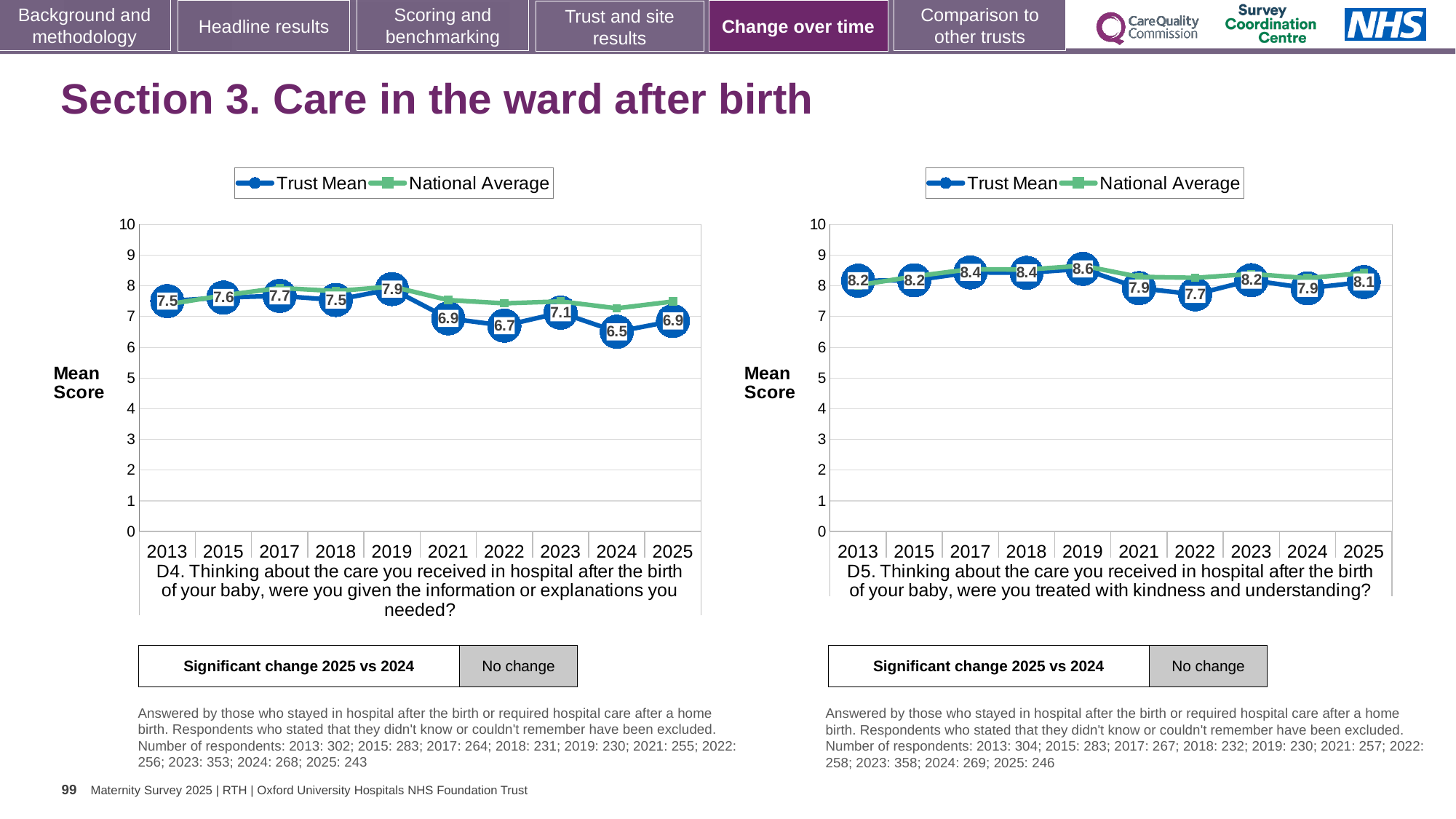
In the left chart (D4), is the National Average for 2025 greater or less than 7? greater In the right chart (D5), what is the Trust Mean score for 2019? 8.6 In the right chart (D5), is the Trust Mean score for 2025 higher or lower than for 2024? higher In the left chart (D4), what is the Trust Mean score for 2019? 7.9 In the left chart (D4), which year has the highest Trust Mean score? 2019 In the left chart (D4), what is the difference between the Trust Mean scores for 2019 and 2024? 1.4 In the right chart (D5), which year has the lowest Trust Mean score? 2022 How many years are plotted on the x axis of the left chart (D4)? 10 In the right chart (D5), what is the Trust Mean score for 2022? 7.7 In the left chart (D4), which year has the lowest Trust Mean score? 2024 How many series does the legend of the right chart (D5) list? 2 In the left chart (D4), what is the Trust Mean score for 2024? 6.5